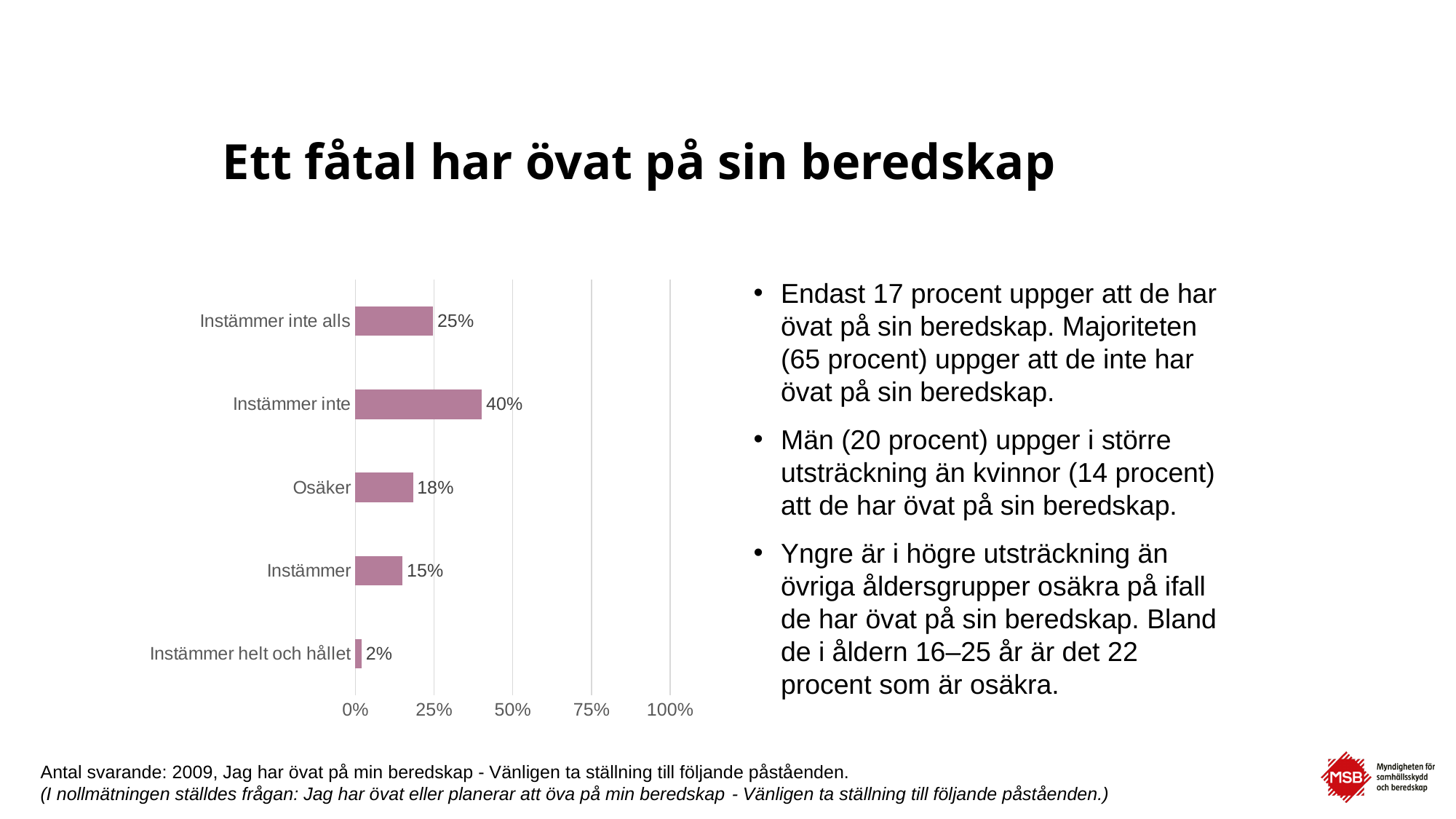
How many categories are shown in the chart? 5 What is the difference between the values for "Instämmer inte" and "Instämmer inte alls"? 15% What is the highest tick value shown on the x axis? 100% Which category has the highest value? Instämmer inte Which category has the lowest value? Instämmer helt och hållet What is the value for "Instämmer inte alls"? 25% What is the value for "Instämmer inte"? 40% Is the value for "Instämmer inte" greater or less than 50%? less What is the value for "Instämmer helt och hållet"? 2% What is the value for "Osäker"? 18% What kind of chart is shown on the slide? bar chart Which is larger, the value for "Osäker" or the value for "Instämmer"? Osäker